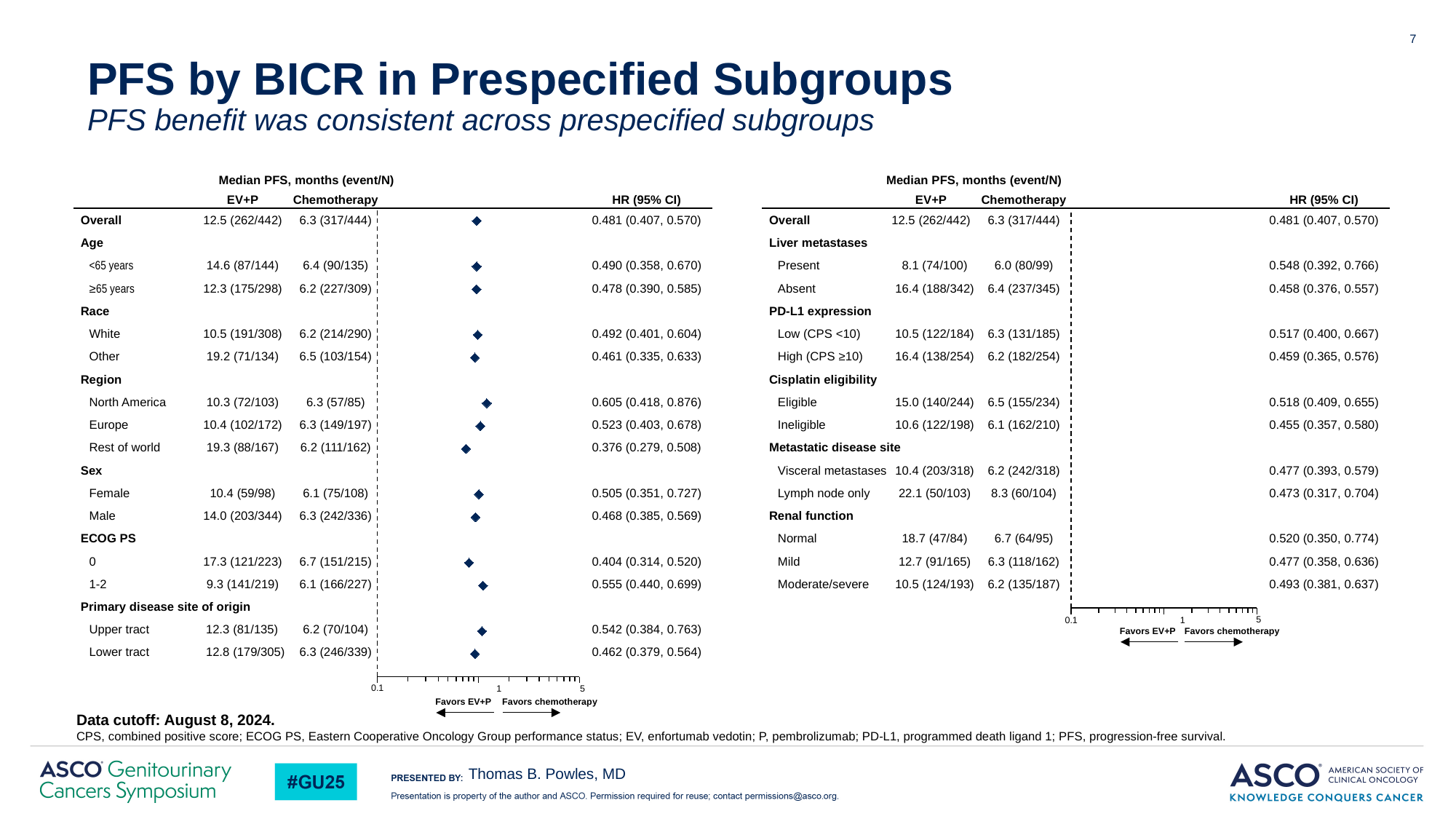
What kind of chart is shown on the slide? Forest plot In the left forest plot, which subgroup has the lowest hazard ratio? Rest of world In the right forest plot, what is the difference in median PFS months between EV+P and Chemotherapy for the Lymph node only subgroup? 13.8 What label appears under the left side of the x axis of each forest plot? Favors EV+P In the left forest plot, is the hazard ratio for the ECOG PS 1-2 subgroup greater or less than 1? less In the left forest plot, what is the HR (95% CI) for the Overall population? 0.481 (0.407, 0.570) How many subgroup rows (including Overall) are plotted in the right forest plot? 12 In the right forest plot, what is the HR (95% CI) for the Lymph node only subgroup? 0.473 (0.317, 0.704) In the left forest plot, what is the median PFS in months for EV+P in the Rest of world subgroup? 19.3 In the left forest plot, which subgroup has the highest hazard ratio? North America In the left forest plot, which has the larger hazard ratio, Female or Male? Female In the right forest plot, which subgroup has the highest hazard ratio? Present (Liver metastases)